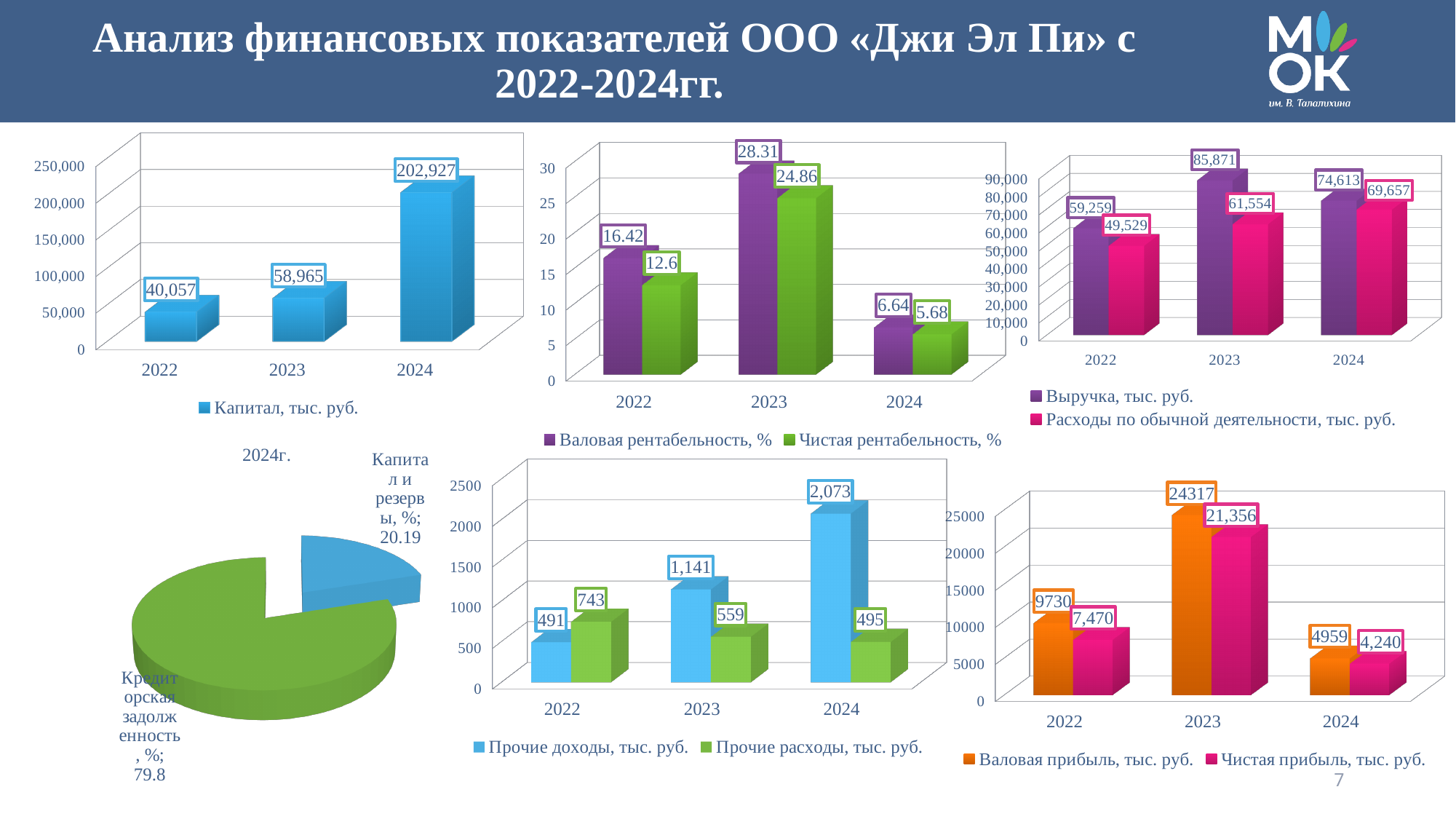
In the top-left chart (Капитал, тыс. руб.), what is the value for 2024? 202,927 What type of chart is the bottom-left chart titled 2024г.? Pie chart In the top-middle chart, what is the difference between Валовая рентабельность, % and Чистая рентабельность, % in 2022? 3.82 In the top-left chart (Капитал, тыс. руб.), which year has the lowest value? 2022 In the top-middle chart, what is the Валовая рентабельность, % value for 2023? 28.31 In the bottom-middle chart, do the Прочие расходы, тыс. руб. values rise or fall from 2022 to 2024? Fall In the bottom-left pie chart (2024г.), what share does Кредиторская задолженность, % have? 79.8 In the top-right chart, what is the Выручка, тыс. руб. value for 2023? 85,871 In the bottom-right chart, what is the Чистая прибыль, тыс. руб. value for 2023? 21,356 How many series does the legend of the bottom-right chart list? 2 In the top-right chart, which is larger in 2024: Выручка, тыс. руб. or Расходы по обычной деятельности, тыс. руб.? Выручка, тыс. руб. In the bottom-middle chart, what is the Прочие доходы, тыс. руб. value for 2024? 2,073